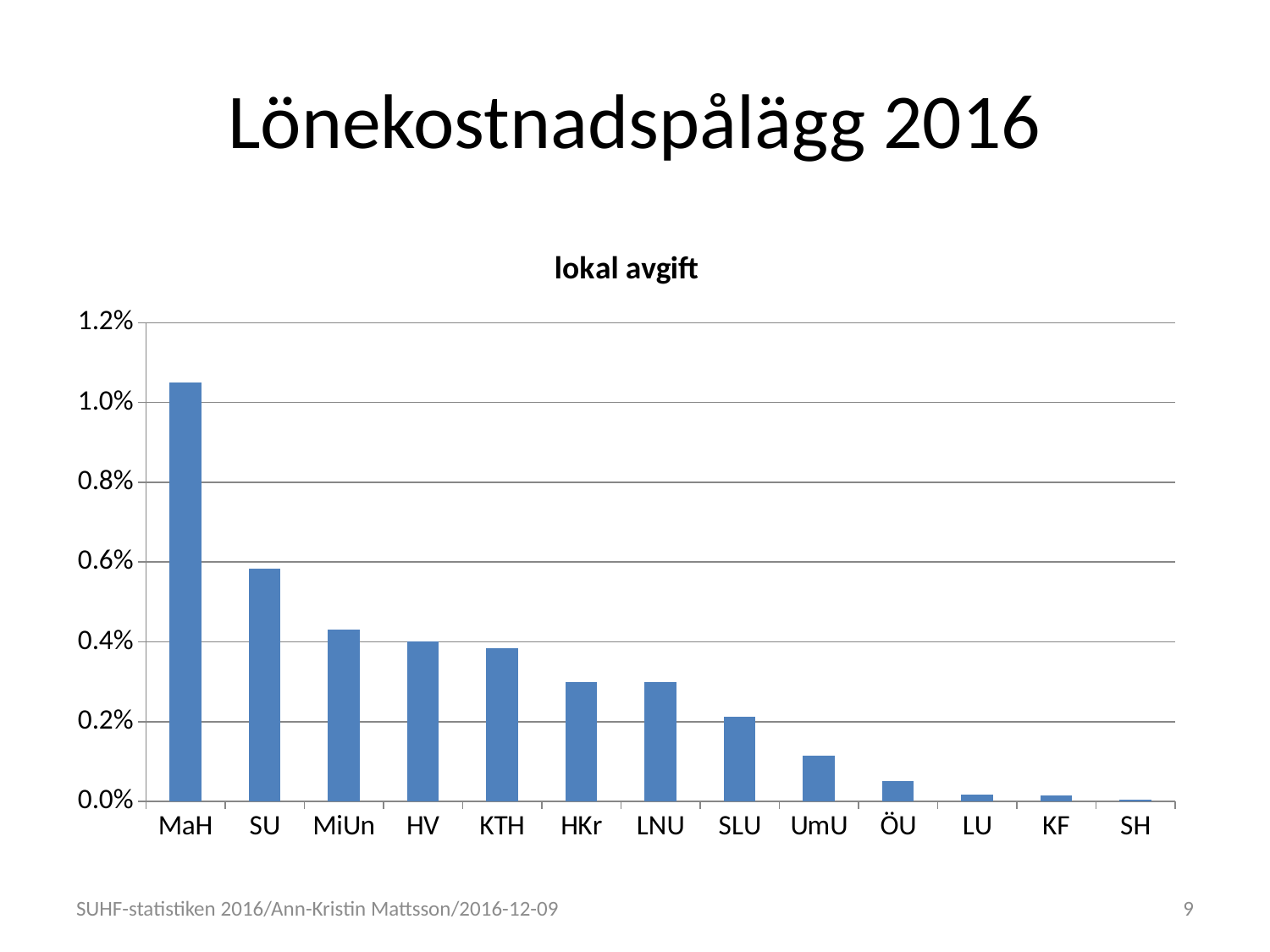
How many categories are shown on the x axis of the chart? 13 What type of chart is shown on the slide? bar chart Is the value for MaH greater or less than 1.0%? greater Which category has the lowest value in the chart? SH Is the value for UmU greater or less than 0.2%? less Do the values rise or fall moving from left to right along the x axis? fall Which has a larger value, MaH or SU? MaH Which has a larger value, SLU or UmU? SLU Which category has the highest value in the chart? MaH Is the value for KTH greater or less than 0.4%? less What is the title of the chart? lokal avgift